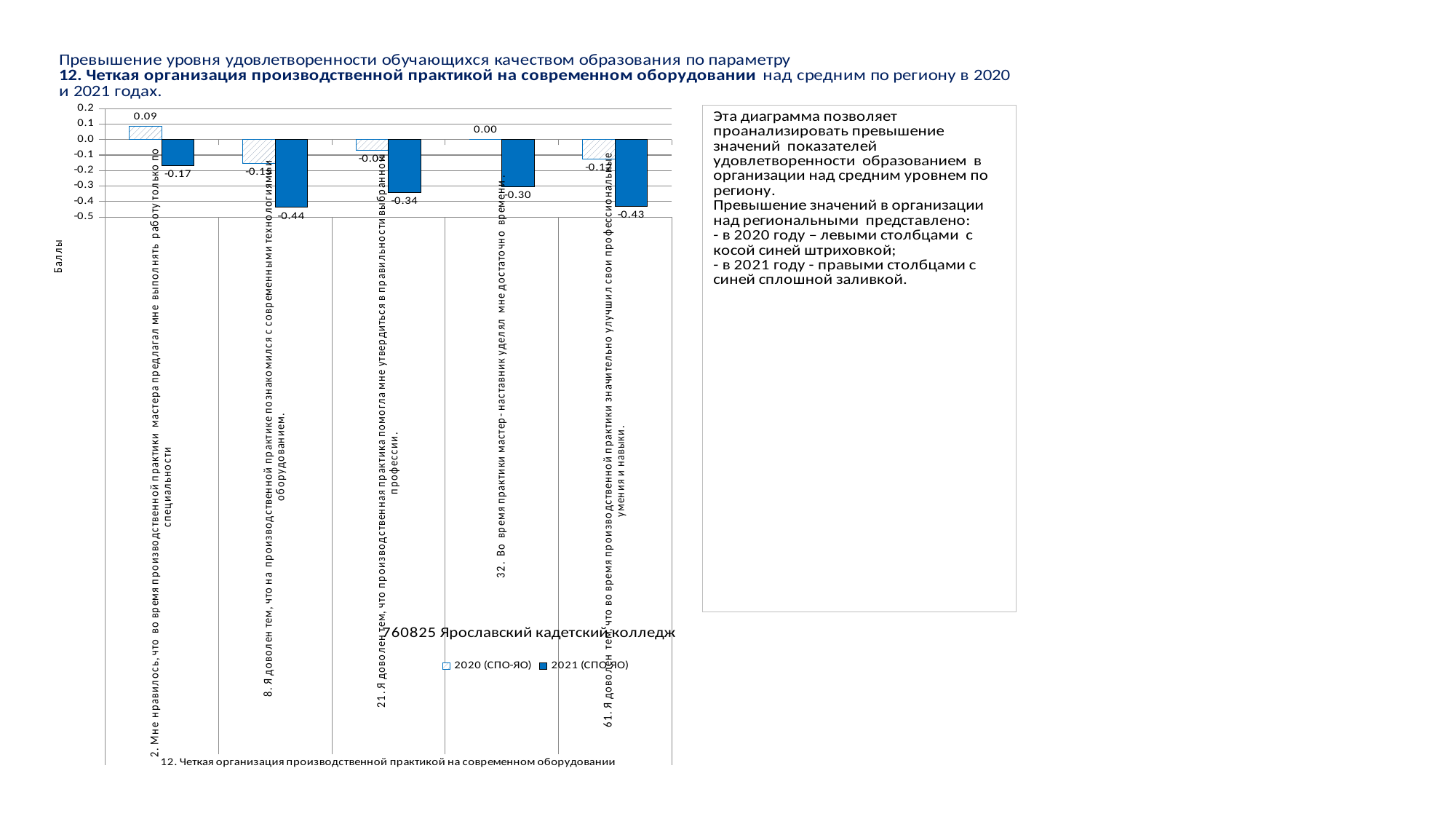
What is the 2020 (СПО-ЯО) value for statement 2 ("Мне нравилось, что во время производственной практики мастера предлагал мне выполнять работу только по специальности")? 0.09 What is the title printed on the chart? 760825 Ярославский кадетский колледж What is the 2020 (СПО-ЯО) value for statement 32 ("Во время практики мастер-наставник уделял мне достаточно времени")? 0.00 What is the 2021 (СПО-ЯО) value for statement 32 ("Во время практики мастер-наставник уделял мне достаточно времени")? -0.30 What is the 2021 (СПО-ЯО) value for statement 2 ("Мне нравилось, что во время производственной практики мастера предлагал мне выполнять работу только по специальности")? -0.17 What is the difference between the 2020 (СПО-ЯО) and 2021 (СПО-ЯО) values for statement 2? 0.26 How many categories (statements) are plotted on the x axis of the chart? 5 What is the 2021 (СПО-ЯО) value for statement 8 ("Я доволен тем, что на производственной практике познакомился с современными технологиями и оборудованием")? -0.44 Which statement has the highest 2020 (СПО-ЯО) value? Statement 2 (Мне нравилось, что во время производственной практики мастера предлагал мне выполнять работу только по специальности) For the 2021 (СПО-ЯО) series, which is larger: the value for statement 32 or the value for statement 21? Statement 32 How many series does the chart legend list? 2 What kind of chart is shown on the slide? bar chart